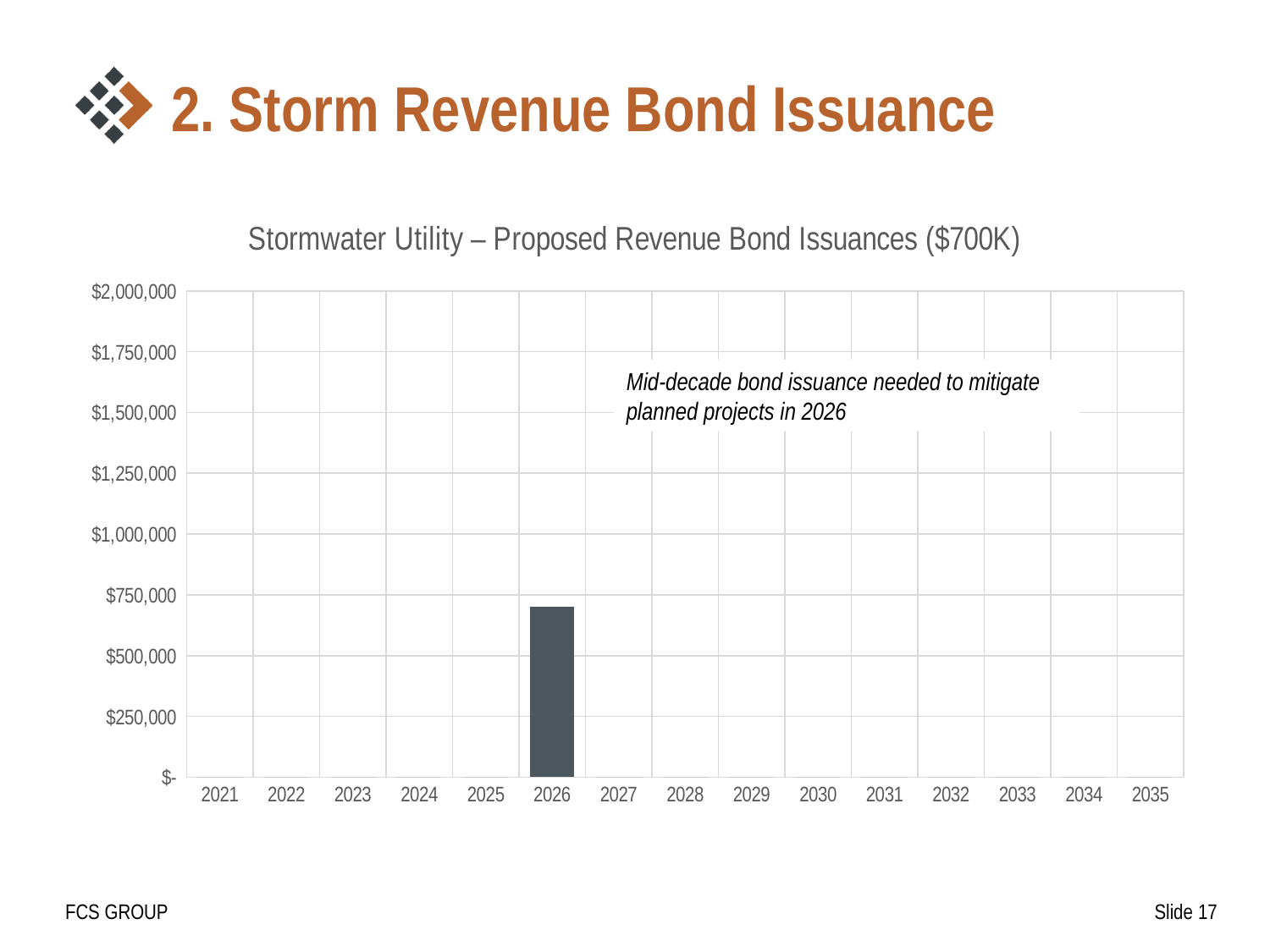
Is the value for 2026 greater or less than $750,000? less What is the title of the chart? Stormwater Utility – Proposed Revenue Bond Issuances ($700K) How many years on the chart show a nonzero bond issuance? 1 What is the proposed revenue bond issuance amount stated in the chart title? $700K Is the value for 2026 greater or less than $500,000? greater What is the first year shown on the x axis? 2021 In which year is a revenue bond issuance shown on the chart? 2026 What is the last year shown on the x axis? 2035 How many years are shown along the x axis of the chart? 15 Which year has a larger bond issuance, 2026 or 2030? 2026 What type of chart is shown on the slide? bar chart What is the highest value labelled on the y axis? $2,000,000